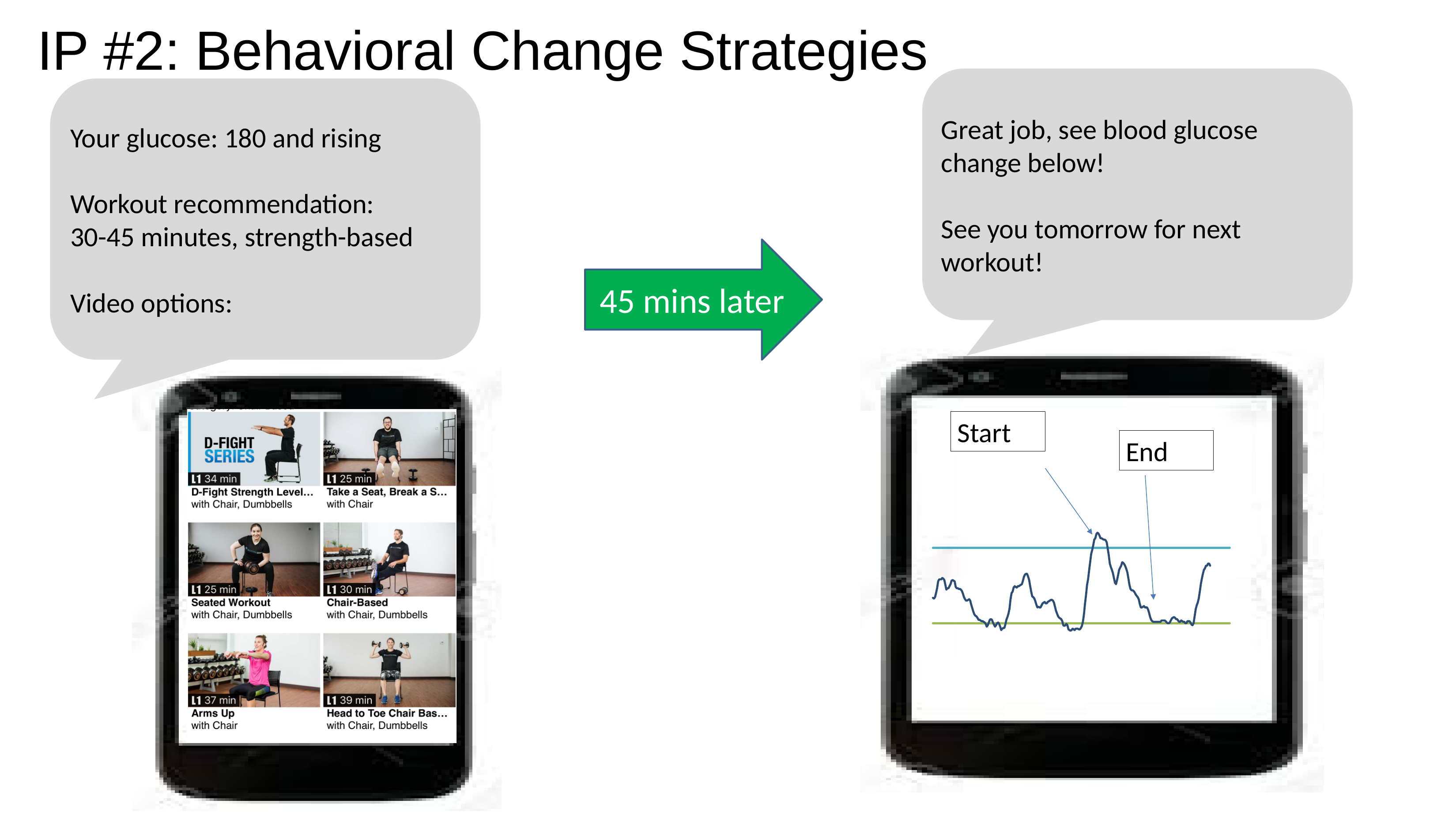
On the blood glucose chart on the right phone screen, does the line rise or fall between the point labelled Start and the point labelled End? fall On the blood glucose chart on the right phone screen, what are the two labelled points on the line called? Start and End What kind of chart is shown on the phone screen on the right of the slide? line chart On the blood glucose chart on the right phone screen, is the point labelled Start above or below the blue horizontal line? above How many horizontal reference lines are drawn across the blood glucose chart on the right phone screen? 2 On the blood glucose chart on the right phone screen, which labelled point has the higher value, Start or End? Start On the blood glucose chart on the right phone screen, what colour is the upper horizontal reference line? blue On the blood glucose chart on the right phone screen, is the point labelled End above or below the blue horizontal line? below